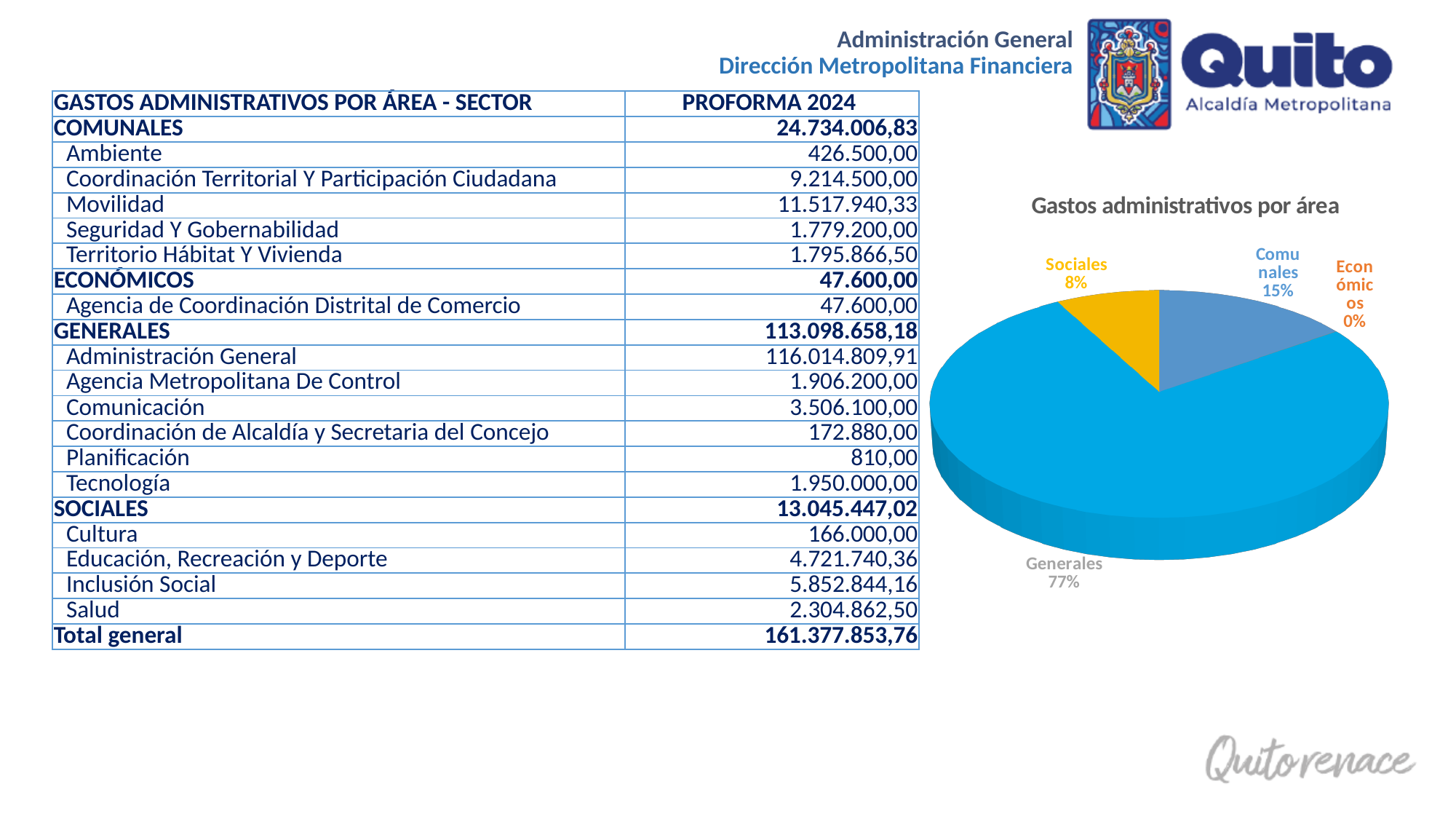
What share of the pie does Comunales represent? 15% What share of the pie does Sociales represent? 8% What kind of chart is shown on the slide? pie chart What colour is the Generales slice in the pie chart? blue Which area has the smallest slice of the pie chart? Económicos What share of the pie does Económicos represent? 0% What is the difference in percentage points between the Generales and Comunales slices? 62 How many slices does the pie chart have? 4 What is the title of the pie chart? Gastos administrativos por área Which slice is larger, Comunales or Sociales? Comunales Which area has the largest slice of the pie chart? Generales